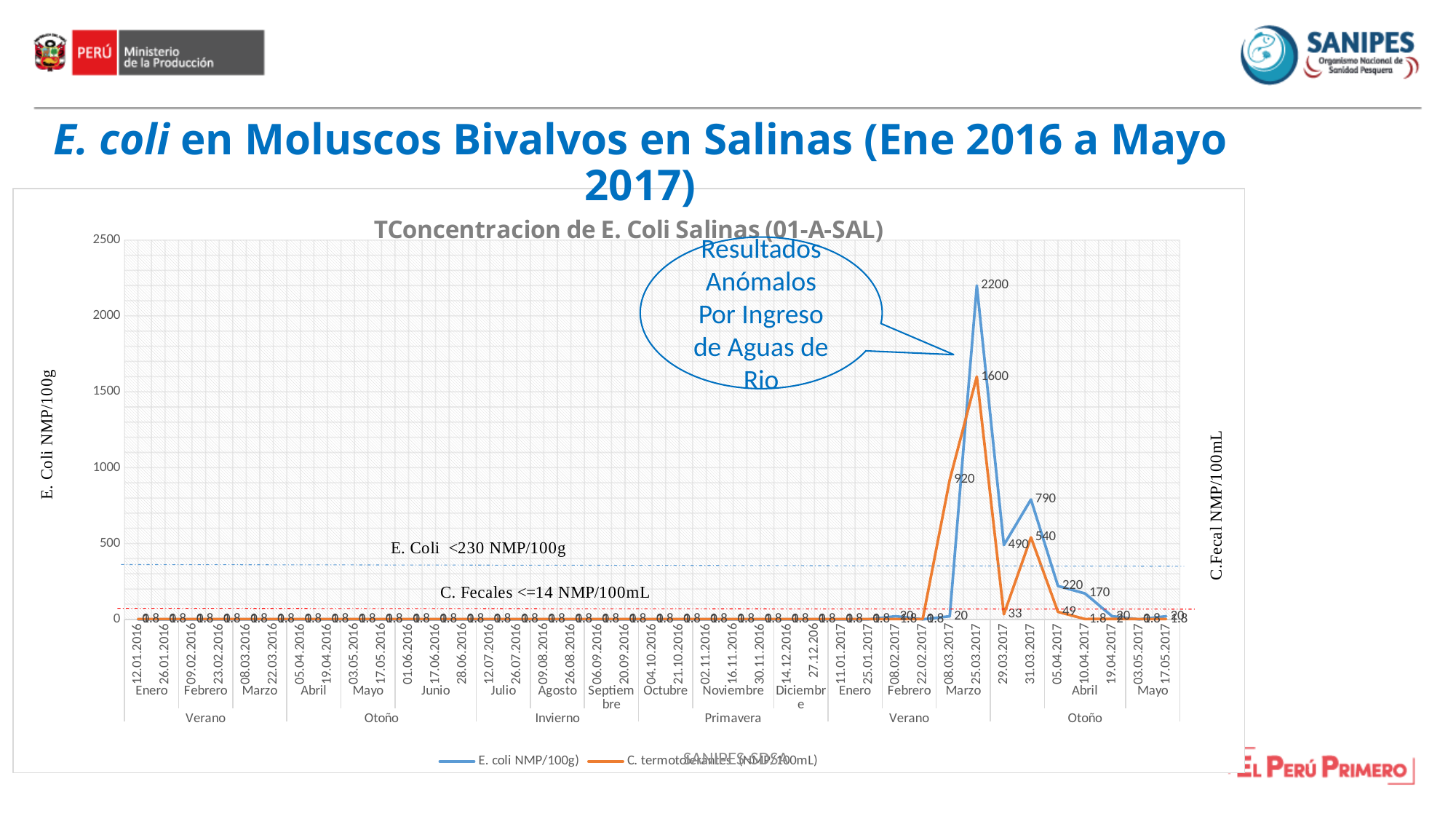
How many series does the chart legend list? 2 What is the title of the chart? TConcentracion de E. Coli Salinas (01-A-SAL) What is the C. termotolerantes (NMP/100mL) value on 08.03.2017? 920 What is the C. termotolerantes (NMP/100mL) value on 25.03.2017? 1600 What is the E. coli NMP/100g value on 25.03.2017? 2200 What is the E. coli NMP/100g value on 31.03.2017? 790 What is the difference between the E. coli value (2200) and the C. termotolerantes value (1600) on 25.03.2017? 600 What is the difference between the E. coli value (790) and the C. termotolerantes value (540) on 31.03.2017? 250 Is the E. coli value on 25.03.2017 greater or less than 2000? greater On which date does the E. coli NMP/100g series reach its highest value? 25.03.2017 On 31.03.2017, which is larger: the E. coli value or the C. termotolerantes value? E. coli What kind of chart is shown on the slide? line chart